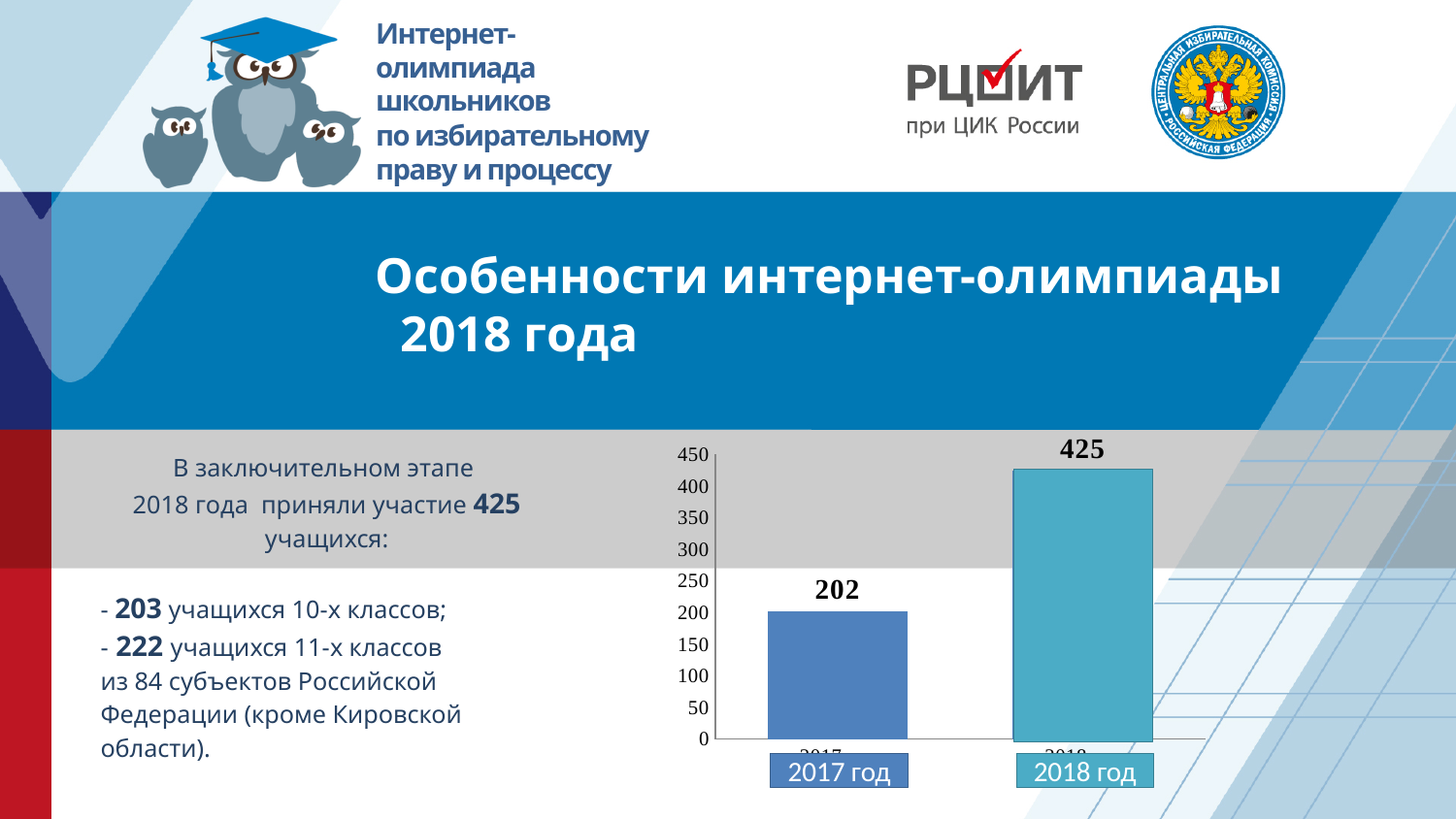
How many categories are shown in the chart? 2 Do the values rise or fall from 2017 год to 2018 год? rise Which is larger, the value for 2017 год or the value for 2018 год? 2018 год What is the difference between the values for 2018 год and 2017 год? 223 Which year has the highest value? 2018 год Is the value for 2018 год greater or less than 400? greater What is the value for 2018 год? 425 What kind of chart is shown on the slide? bar chart What is the highest value shown on the vertical axis of the chart? 450 What is the value for 2017 год? 202 Is the value for 2017 год greater or less than 250? less Which year has the lowest value? 2017 год